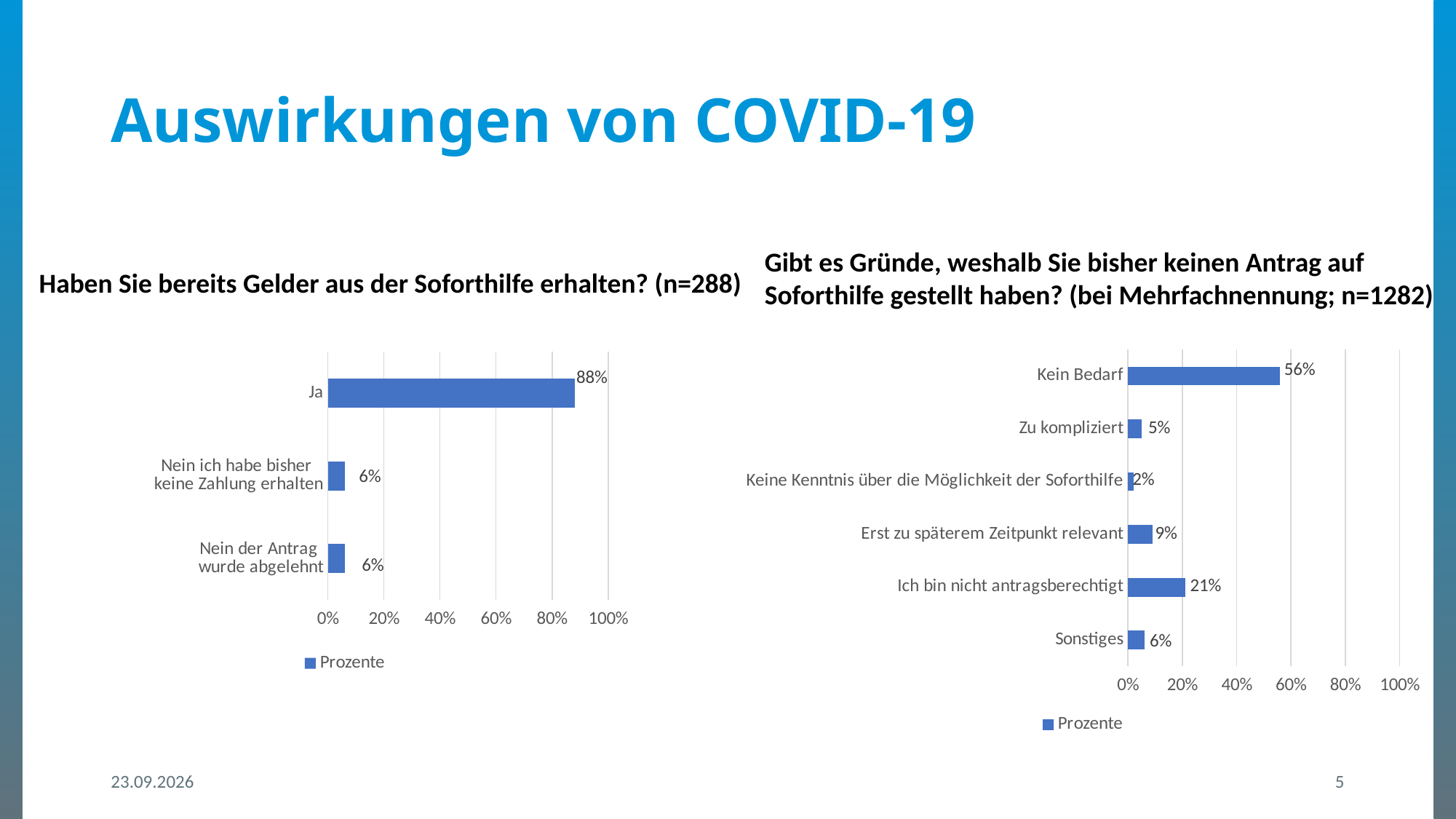
In the left chart (Haben Sie bereits Gelder aus der Soforthilfe erhalten?), what is the value for "Nein der Antrag wurde abgelehnt"? 6% What kind of chart is the right chart (Gibt es Gründe, weshalb Sie bisher keinen Antrag auf Soforthilfe gestellt haben?)? Bar chart In the right chart (Gibt es Gründe, weshalb Sie bisher keinen Antrag auf Soforthilfe gestellt haben?), what is the difference between "Kein Bedarf" and "Ich bin nicht antragsberechtigt"? 35% In the left chart (Haben Sie bereits Gelder aus der Soforthilfe erhalten?), what is the difference between "Ja" and "Nein ich habe bisher keine Zahlung erhalten"? 82% In the right chart (Gibt es Gründe, weshalb Sie bisher keinen Antrag auf Soforthilfe gestellt haben?), which is larger: "Erst zu späterem Zeitpunkt relevant" or "Zu kompliziert"? Erst zu späterem Zeitpunkt relevant In the left chart (Haben Sie bereits Gelder aus der Soforthilfe erhalten?), which category has the highest value? Ja In the right chart (Gibt es Gründe, weshalb Sie bisher keinen Antrag auf Soforthilfe gestellt haben?), how many categories are shown? 6 In the right chart (Gibt es Gründe, weshalb Sie bisher keinen Antrag auf Soforthilfe gestellt haben?), what is the value for "Ich bin nicht antragsberechtigt"? 21% In the left chart (Haben Sie bereits Gelder aus der Soforthilfe erhalten?), what is the value for "Ja"? 88% In the right chart (Gibt es Gründe, weshalb Sie bisher keinen Antrag auf Soforthilfe gestellt haben?), what is the value for "Kein Bedarf"? 56% In the left chart (Haben Sie bereits Gelder aus der Soforthilfe erhalten?), how many categories are shown? 3 In the right chart (Gibt es Gründe, weshalb Sie bisher keinen Antrag auf Soforthilfe gestellt haben?), which category has the lowest value? Keine Kenntnis über die Möglichkeit der Soforthilfe